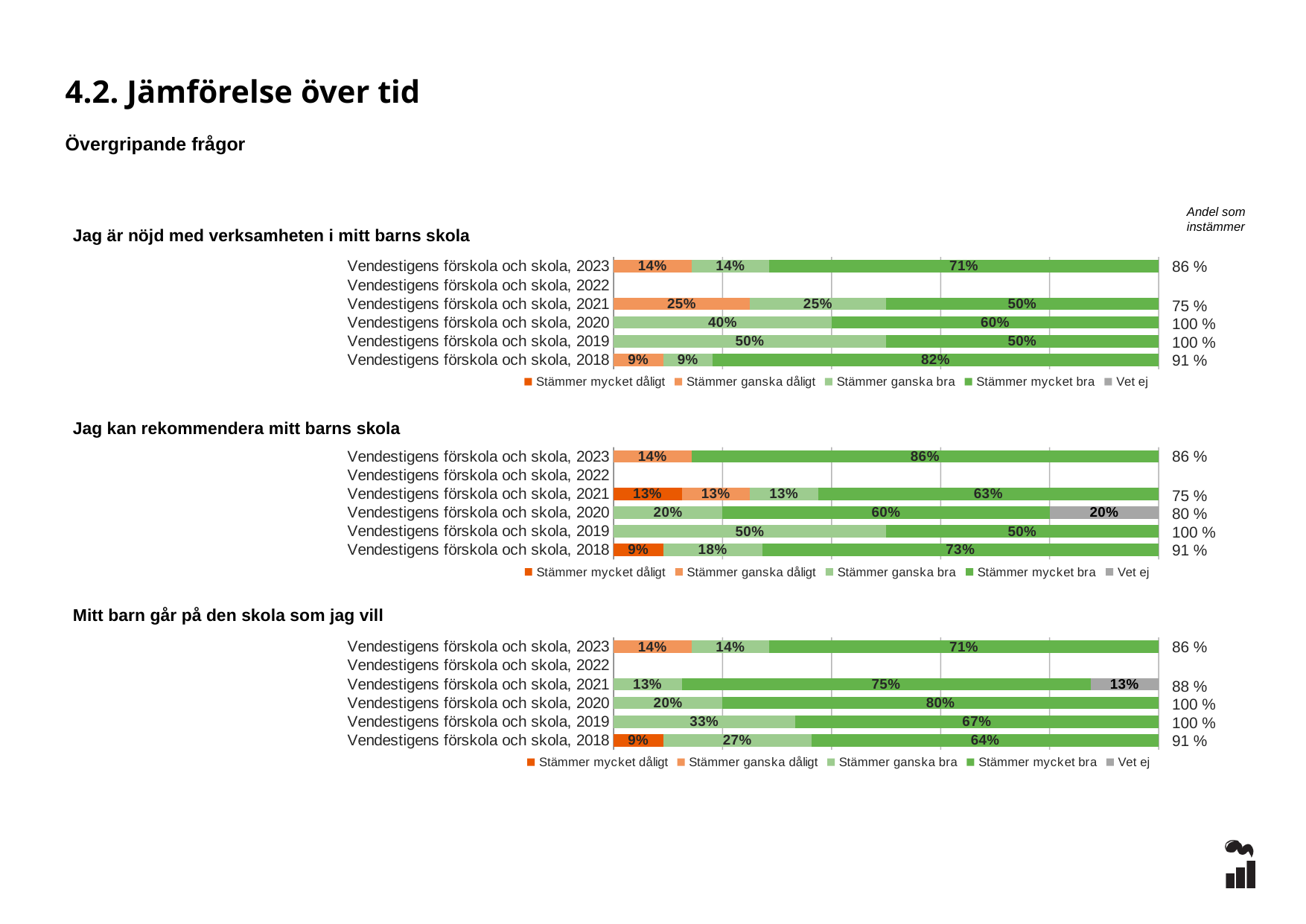
In the chart 'Jag kan rekommendera mitt barns skola', what is the 'Stämmer mycket bra' value for Vendestigens förskola och skola, 2023? 86% In the chart 'Jag är nöjd med verksamheten i mitt barns skola', what is the 'Stämmer mycket bra' value for Vendestigens förskola och skola, 2018? 82% In the chart 'Mitt barn går på den skola som jag vill', what is the 'Andel som instämmer' value shown for 2021? 88 % In the chart 'Jag är nöjd med verksamheten i mitt barns skola', which year has the highest 'Stämmer mycket bra' value? 2018 How many series does the legend of the chart 'Jag är nöjd med verksamheten i mitt barns skola' list? 5 What kind of chart is 'Jag kan rekommendera mitt barns skola'? Stacked bar chart In the chart 'Jag är nöjd med verksamheten i mitt barns skola', what is the 'Stämmer ganska dåligt' value for Vendestigens förskola och skola, 2021? 25% In the chart 'Mitt barn går på den skola som jag vill', is the 'Stämmer mycket bra' value larger for 2020 or for 2018? 2020 In the chart 'Jag kan rekommendera mitt barns skola', which year has the lowest 'Stämmer mycket bra' value? 2019 In the chart 'Jag kan rekommendera mitt barns skola', what is the difference between the 'Stämmer mycket bra' values for 2023 and 2021? 23% In the chart 'Mitt barn går på den skola som jag vill', what is the 'Stämmer ganska bra' value for Vendestigens förskola och skola, 2019? 33% In the chart 'Jag kan rekommendera mitt barns skola', what is the 'Vet ej' value for Vendestigens förskola och skola, 2020? 20%